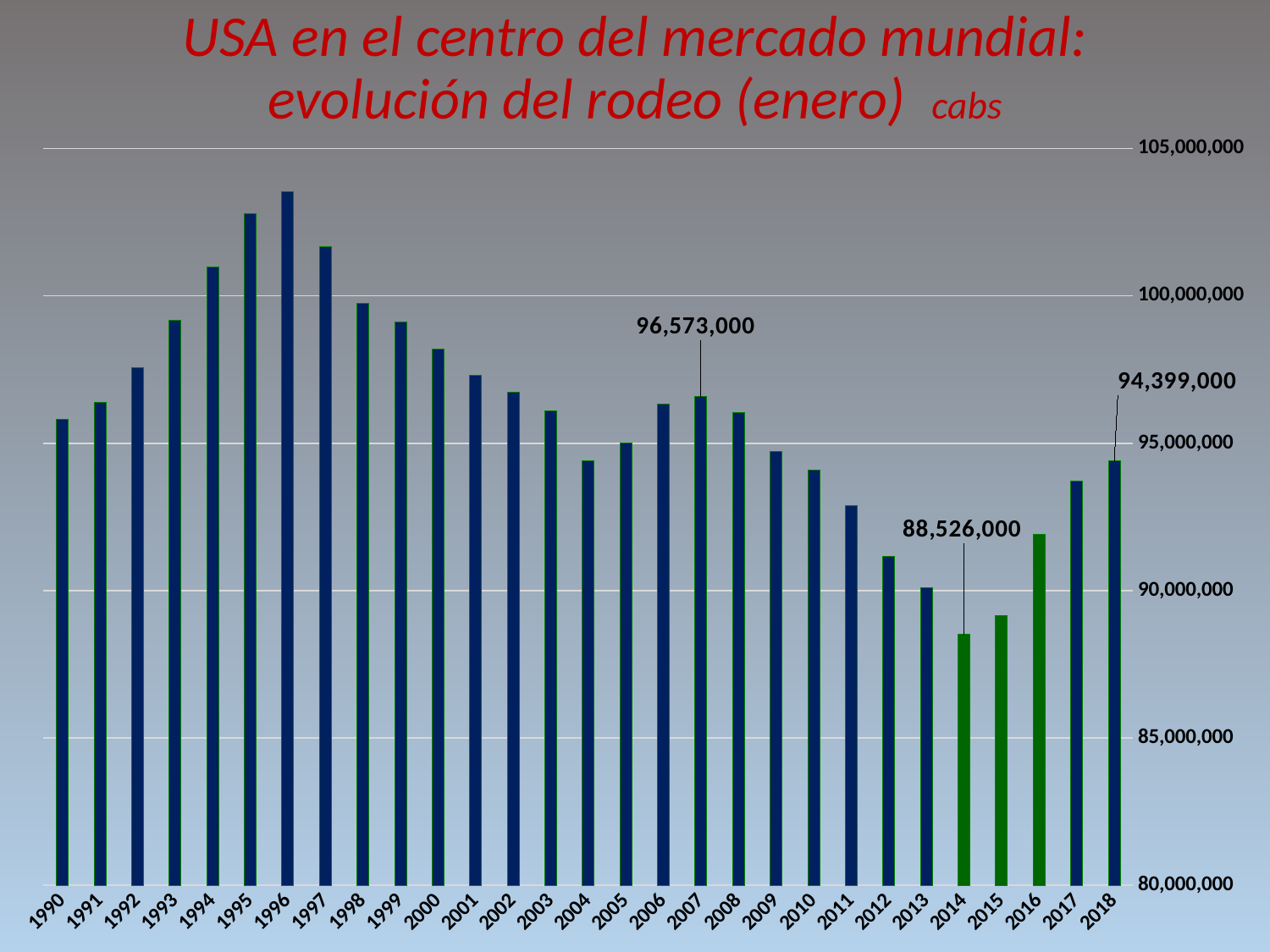
What is the value for 2014? 88,526,000 How many years are shown on the x axis? 29 What is the value for 2018? 94,399,000 Is the value for 2010 greater or less than 95,000,000? less Which year has the lowest bar? 2014 What is the value for 2007? 96,573,000 Which is larger, the value for 2007 or the value for 2018? 2007 What is the difference between the values for 2018 and 2014? 5,873,000 What kind of chart is shown on the slide? Bar chart Is the value for 1996 greater or less than 100,000,000? greater What is the difference between the values for 2007 and 2014? 8,047,000 Which year has the highest bar? 1996